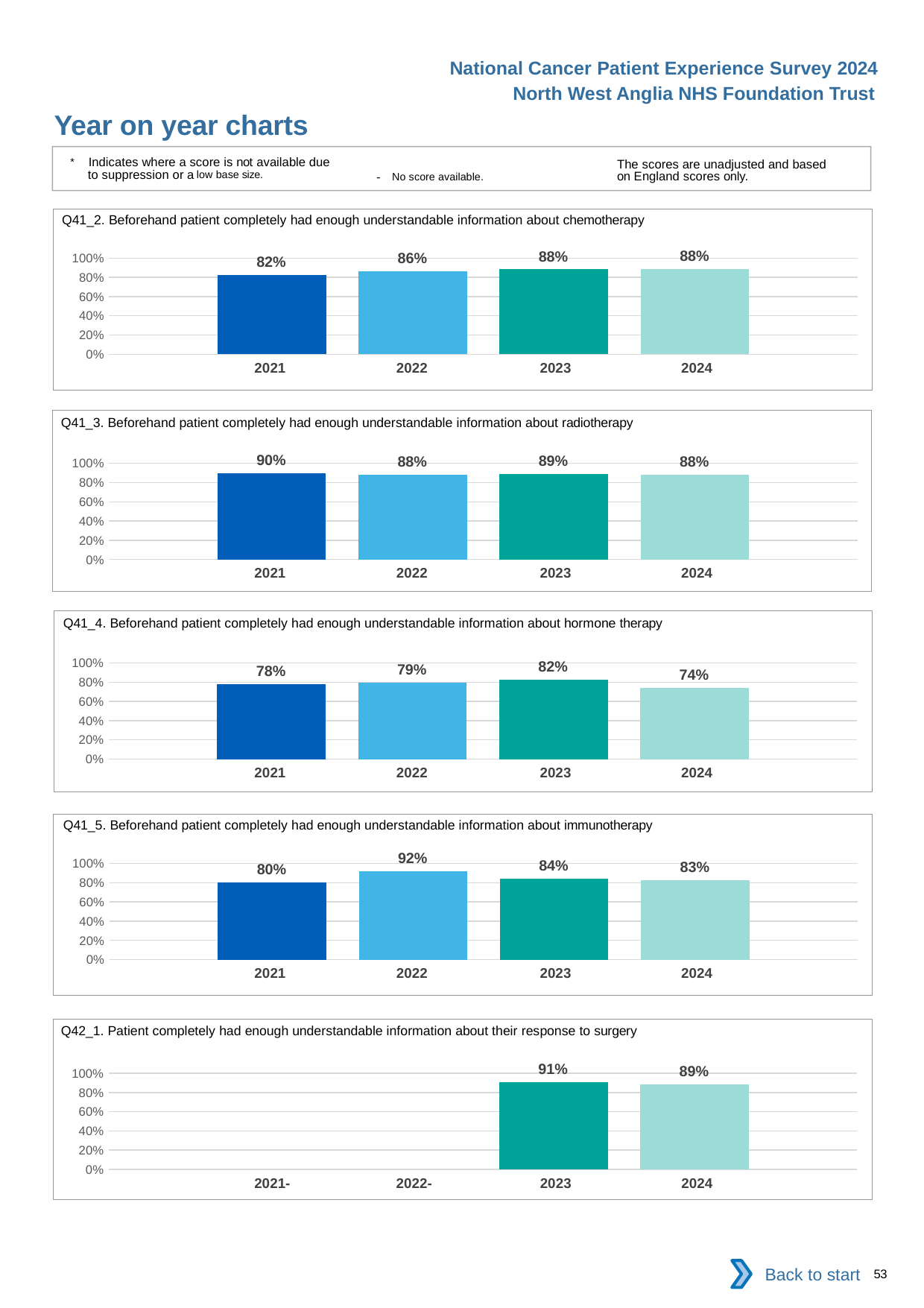
In the Q41_4 chart (hormone therapy), is the value for 2024 greater or less than 80%? less In the Q41_2 chart (chemotherapy), do the values rise or fall from 2021 to 2023? rise In the Q41_3 chart (radiotherapy), which year has the highest value? 2021 In the Q41_5 chart (immunotherapy), what is the value for 2024? 83% In the Q42_1 chart (response to surgery), which is larger, the value for 2023 or 2024? 2023 What kind of chart is the Q41_2 chart (chemotherapy)? bar chart How many bars are plotted in the Q42_1 chart (response to surgery)? 2 In the Q41_5 chart (immunotherapy), what is the difference between the 2022 and 2021 values? 12% In the Q41_2 chart (chemotherapy), what is the value for 2021? 82% In the Q41_3 chart (radiotherapy), what is the difference between the 2021 and 2024 values? 2% In the Q41_4 chart (hormone therapy), which year has the lowest value? 2024 How many charts are shown on the slide? 5